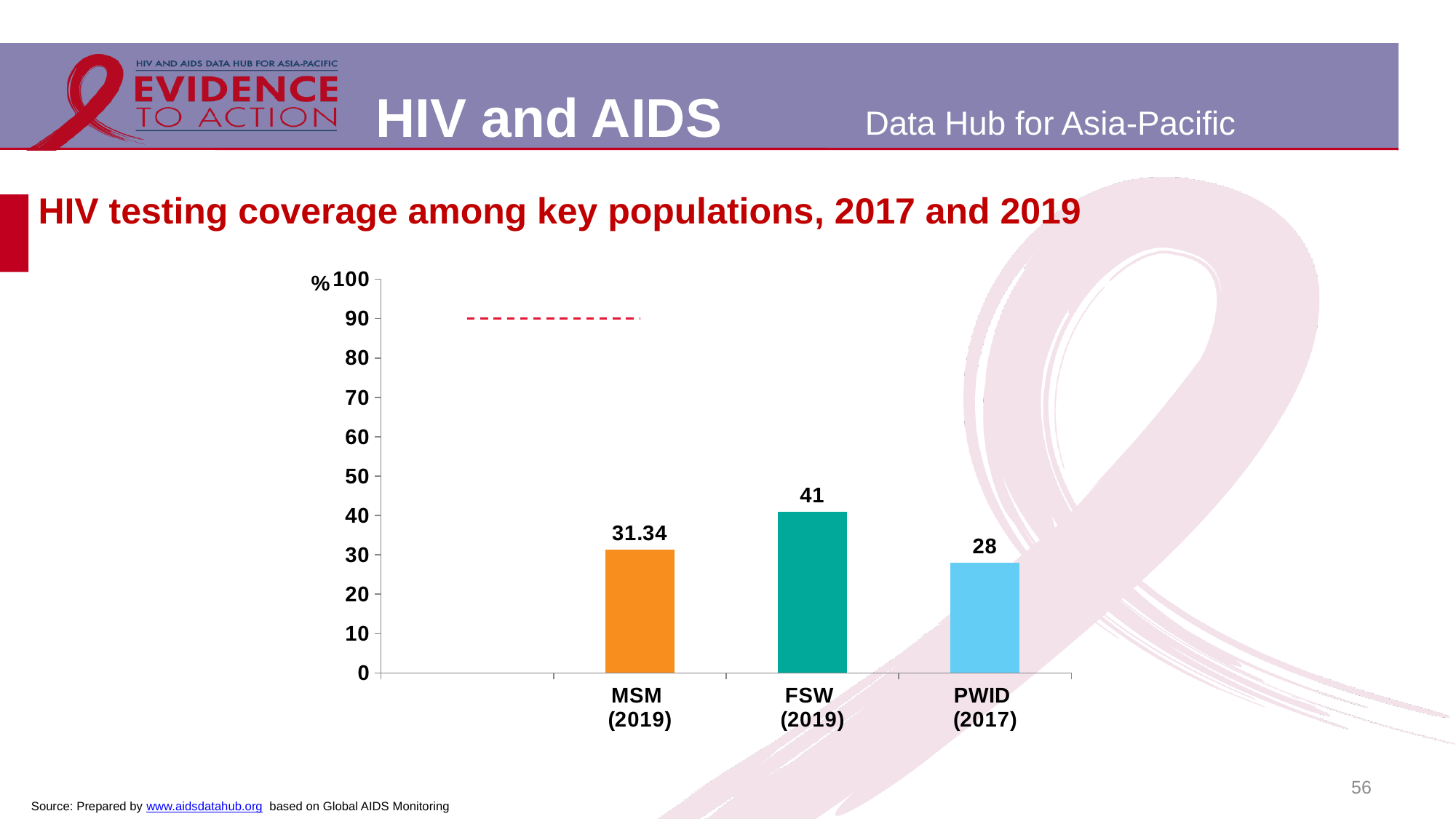
What is the difference between the HIV testing coverage for FSW (2019) and PWID (2017)? 13 Which key population has the highest HIV testing coverage? FSW (2019) Which has a higher HIV testing coverage, MSM (2019) or PWID (2017)? MSM (2019) What is the difference between the HIV testing coverage for FSW (2019) and MSM (2019)? 9.66 Which key population has the lowest HIV testing coverage? PWID (2017) What is the HIV testing coverage value for MSM (2019)? 31.34 What is the title of the chart on the slide? HIV testing coverage among key populations, 2017 and 2019 What is the HIV testing coverage value for FSW (2019)? 41 Is the value for FSW (2019) greater or less than 50? less What is the HIV testing coverage value for PWID (2017)? 28 What kind of chart is shown on the slide? bar chart How many key population categories are shown in the chart? 3